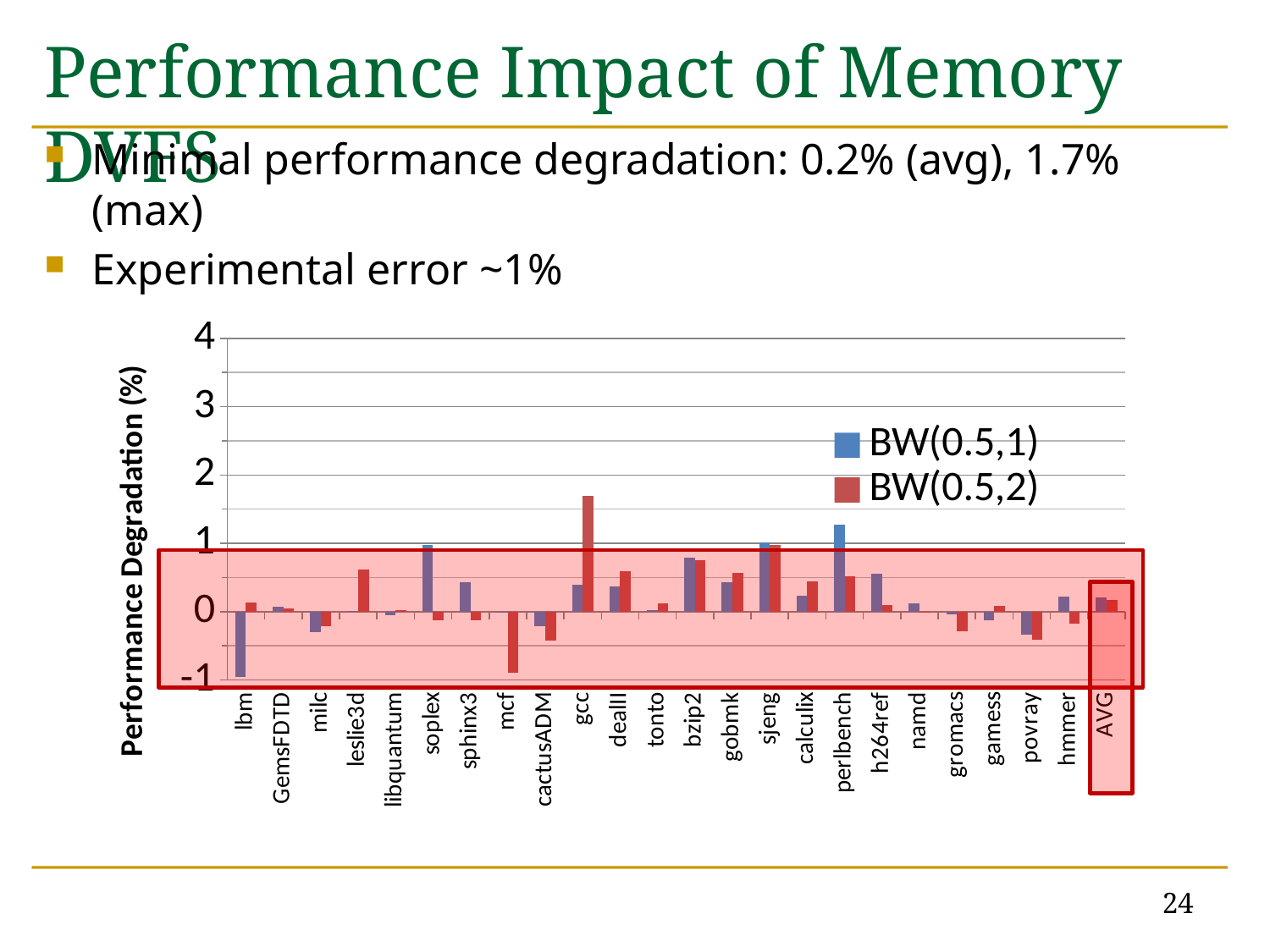
For perlbench, which series has the larger value, BW(0.5,1) or BW(0.5,2)? BW(0.5,1) What are the two series named in the chart's legend? BW(0.5,1) and BW(0.5,2) Which category has the highest BW(0.5,1) value in the chart? perlbench Is the BW(0.5,2) value for gcc greater or less than 1? greater Which category has the lowest BW(0.5,1) value in the chart? lbm What kind of chart is shown on the slide? bar chart How many categories are shown along the x axis of the chart? 24 What is the label of the y axis of the chart? Performance Degradation (%) How many series does the chart's legend list? 2 For gcc, which series has the larger value, BW(0.5,1) or BW(0.5,2)? BW(0.5,2) Is the BW(0.5,1) value for lbm greater or less than 0? less Which category has the highest BW(0.5,2) value in the chart? gcc